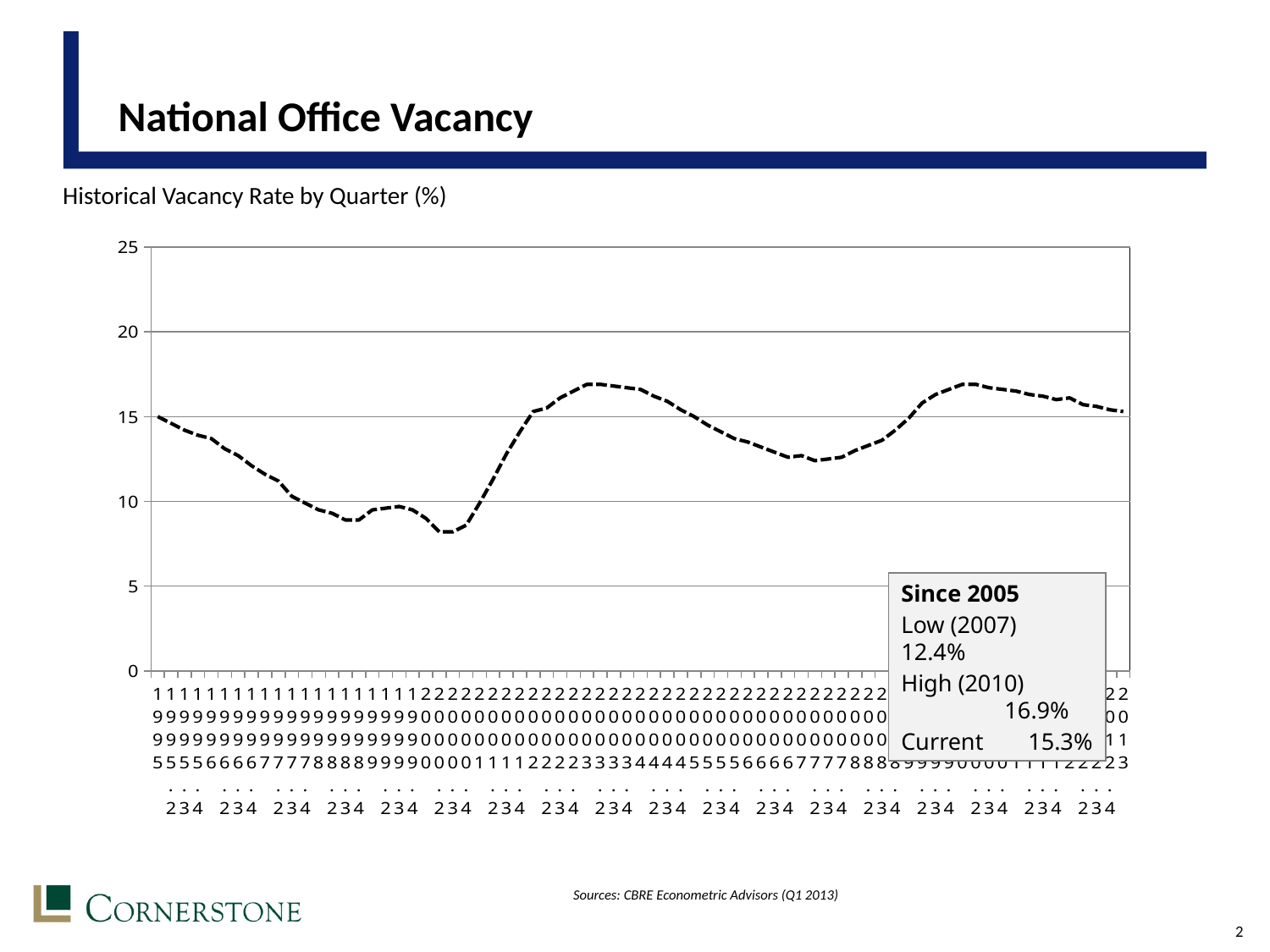
Does the vacancy rate rise or fall between 2000 and 2003? rise According to the annotation box, what was the low vacancy rate since 2005, and in which year did it occur? 12.4% (2007) What is the difference between the high (2010) and low (2007) vacancy rates listed in the annotation box? 4.5 percentage points According to the annotation box, what is the current national office vacancy rate? 15.3% Which is larger: the current vacancy rate or the 2010 high listed in the annotation box? the 2010 high Is the vacancy rate at its peak around 2003 greater or less than 15? greater What is the title of the slide's chart section? Historical Vacancy Rate by Quarter (%) What kind of chart is shown on the slide? line chart According to the annotation box, what was the high vacancy rate since 2005, and in which year did it occur? 16.9% (2010) Does the vacancy rate rise or fall between 2010 and 2013? fall Is the vacancy rate at its lowest point around 2000 greater or less than 10? less What is the highest value shown on the vertical axis? 25